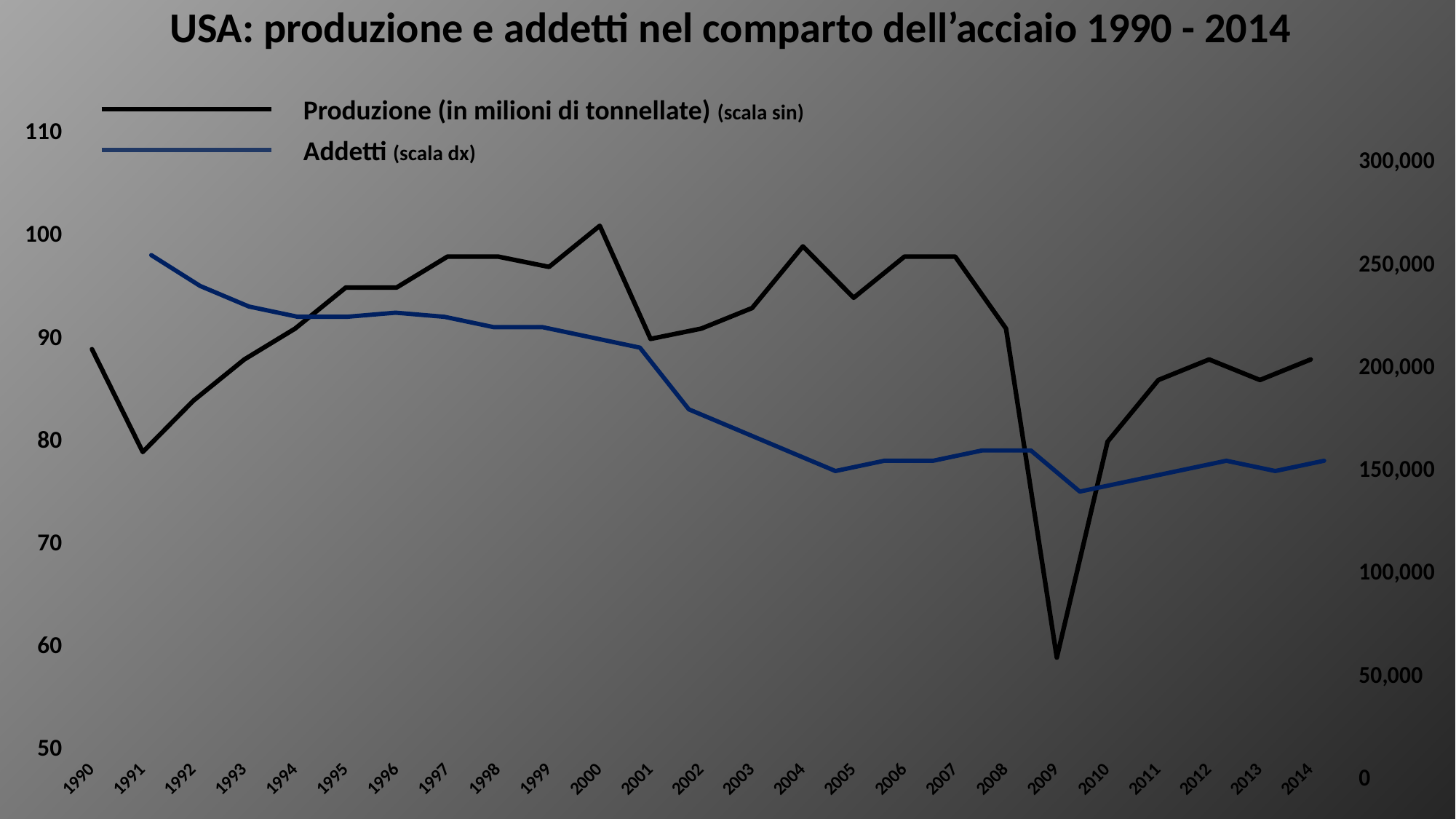
Which year has the larger Addetti value, 1991 or 2010? 1991 Is the Produzione value for 1995 greater or less than 90? greater Which axis does the Addetti series use, according to the legend? the right axis (scala dx) How many years are shown along the x axis? 25 Is the Addetti value for 2014 greater or less than 200,000? less In which year is Addetti at its highest? 1991 In which year is Produzione at its highest? 2000 Overall, does the Addetti line rise or fall from 1991 to 2014? fall Is the Produzione value for 2009 greater or less than 70? less What kind of chart is shown on the slide? line chart How many series does the legend list? 2 In which year is Produzione at its lowest? 2009